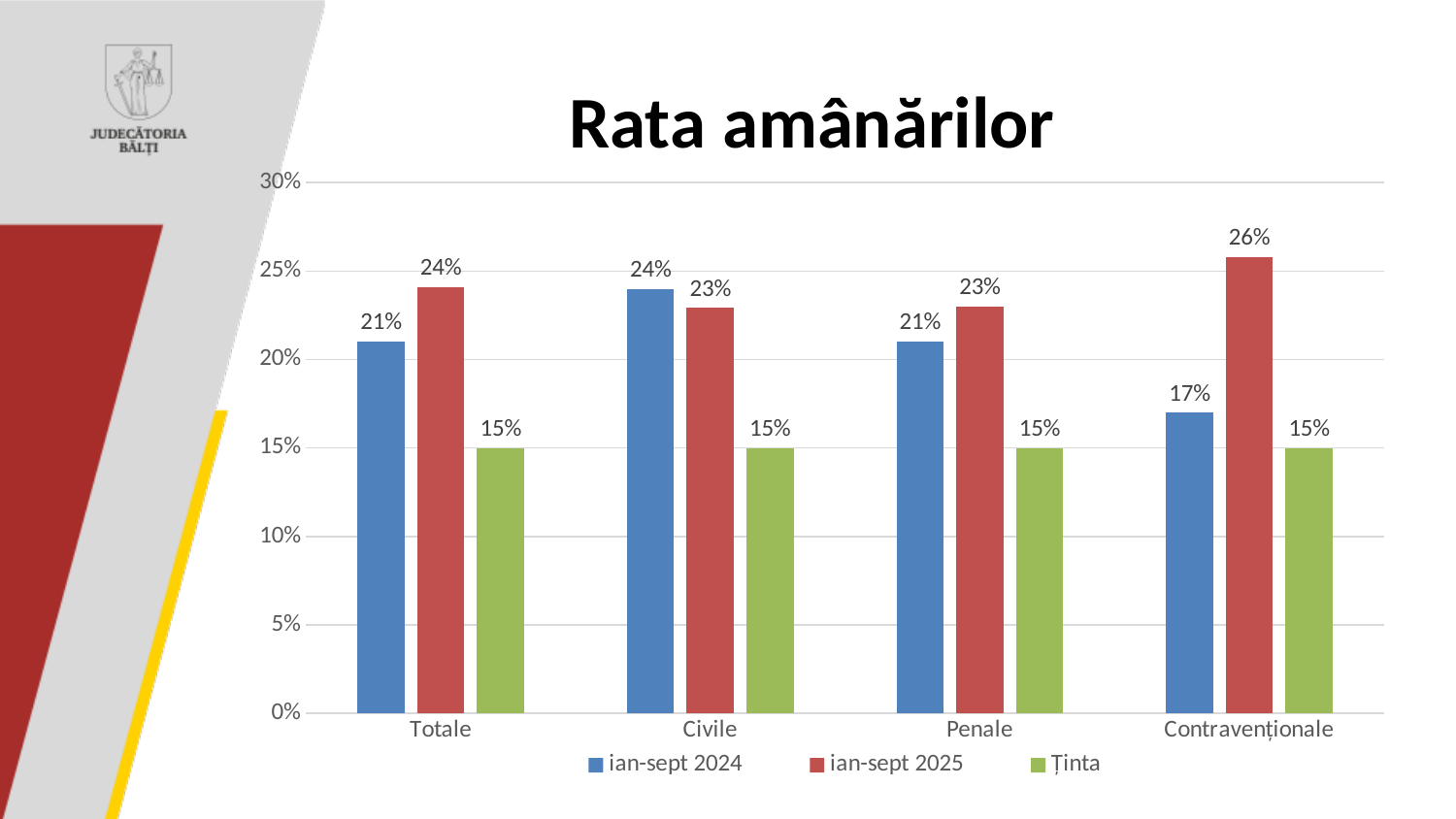
What is the difference between the ian-sept 2025 and ian-sept 2024 values for Contravenționale? 9% What kind of chart is shown on the slide? bar chart Which category has the highest ian-sept 2025 value? Contravenționale Is the ian-sept 2025 value for Penale greater or less than 20%? greater Which category has the lowest ian-sept 2024 value? Contravenționale What is the Ținta value for the Civile category? 15% What is the value for ian-sept 2025 in the Contravenționale category? 26% In the Civile category, which is larger: ian-sept 2024 or ian-sept 2025? ian-sept 2024 How many series does the legend list? 3 What is the value for ian-sept 2024 in the Totale category? 21% What is the title of the chart? Rata amânărilor How many categories are shown on the x axis? 4